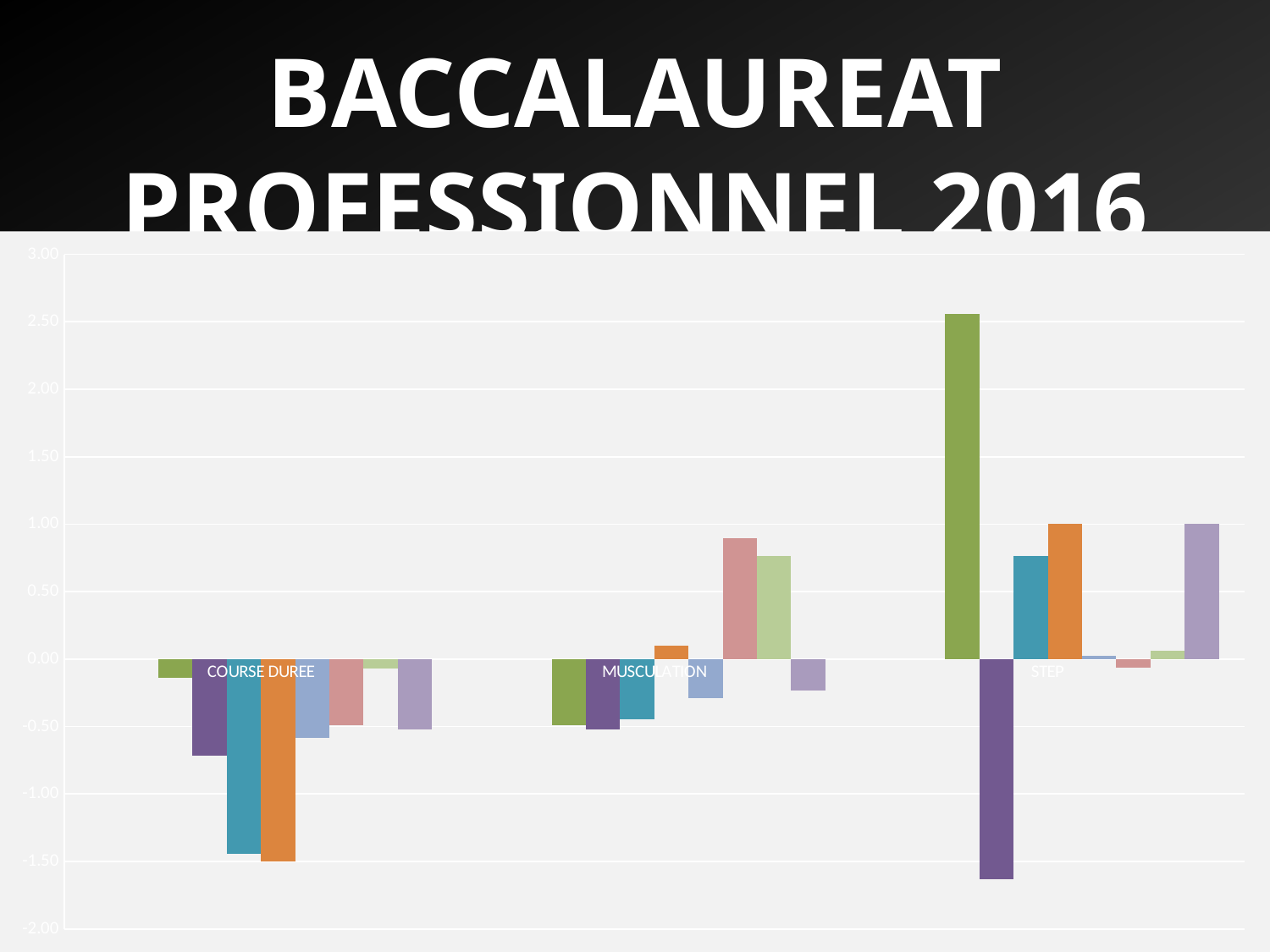
Which category contains the tallest positive bar in the chart? STEP What kind of chart is shown on the slide? bar chart Which is larger: the orange bar in the STEP category or the orange bar in the MUSCULATION category? STEP What is the title shown above the chart? BACCALAUREAT PROFESSIONNEL 2016 Is the value of the purple bar in the STEP category greater or less than -1.00? less Which is larger: the green bar in the STEP category or the green bar in the MUSCULATION category? STEP Is the value of the green bar in the STEP category greater or less than 2.00? greater What are the three categories shown on the x axis of the chart? COURSE DUREE, MUSCULATION, STEP Is the value of the teal bar in the COURSE DUREE category greater or less than -1.00? less How many categories are shown on the x axis of the chart? 3